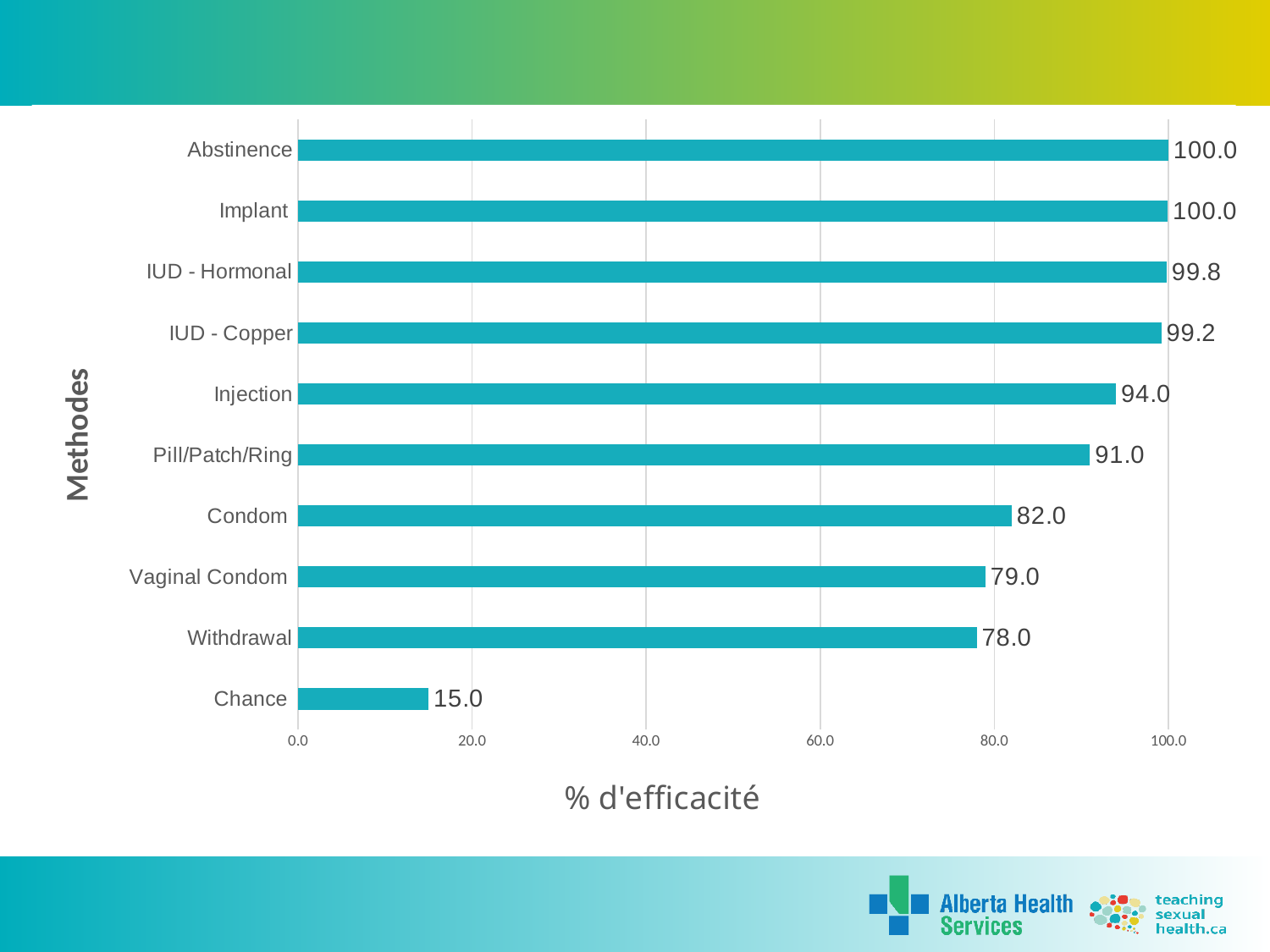
What is the difference between the values for Pill/Patch/Ring and Withdrawal? 13.0 Which category has the lowest value? Chance What is the difference between the values for Abstinence and Chance? 85.0 What is the value for IUD - Copper? 99.2 Is the value for Withdrawal greater or less than 80.0? less What is the value for Injection? 94.0 What kind of chart is shown on the slide? bar chart What is the value for Condom? 82.0 How many categories are shown on the chart? 10 What is the label of the vertical axis? Methodes Which is larger, the value for Condom or the value for Vaginal Condom? Condom What is the label of the horizontal axis? % d'efficacité